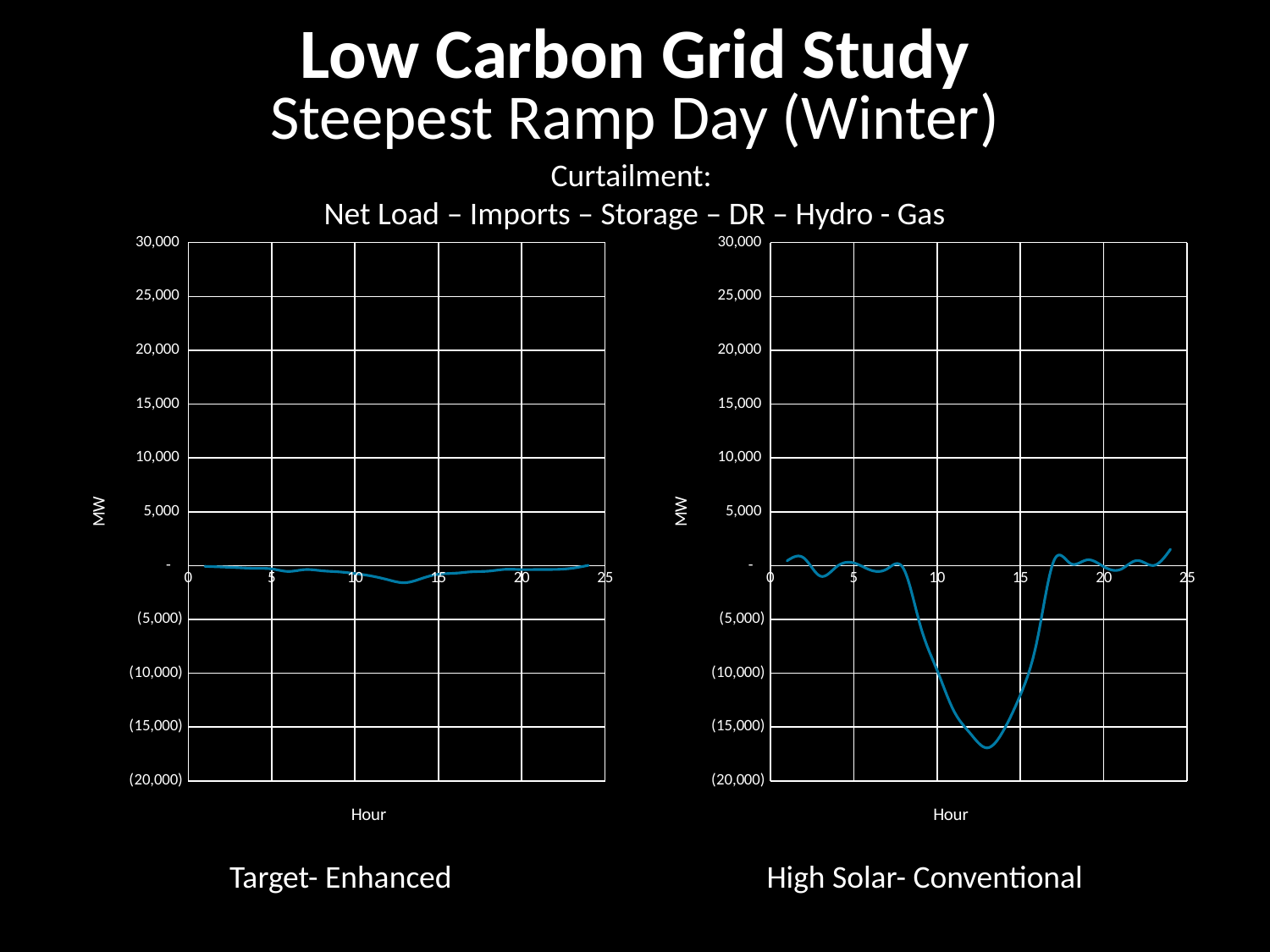
What is the x-axis label on both charts? Hour What kind of chart is the Target- Enhanced chart on the left? line chart Which chart shows the deeper negative dip in the line, Target- Enhanced or High Solar- Conventional? High Solar- Conventional What is the y-axis label on both charts? MW On the High Solar- Conventional chart, does the line rise or fall between hour 13 and hour 17? rise On the Target- Enhanced chart, is the lowest value of the line greater or less than (5,000)? greater On the High Solar- Conventional chart, is the value at hour 11 greater or less than (15,000)? greater On the High Solar- Conventional chart, is the value at hour 5 greater or less than 5,000? less On the High Solar- Conventional chart, does the line rise or fall between hour 8 and hour 13? fall What is the highest value shown on the y-axis of the Target- Enhanced chart? 30,000 What kind of chart is the High Solar- Conventional chart on the right? line chart